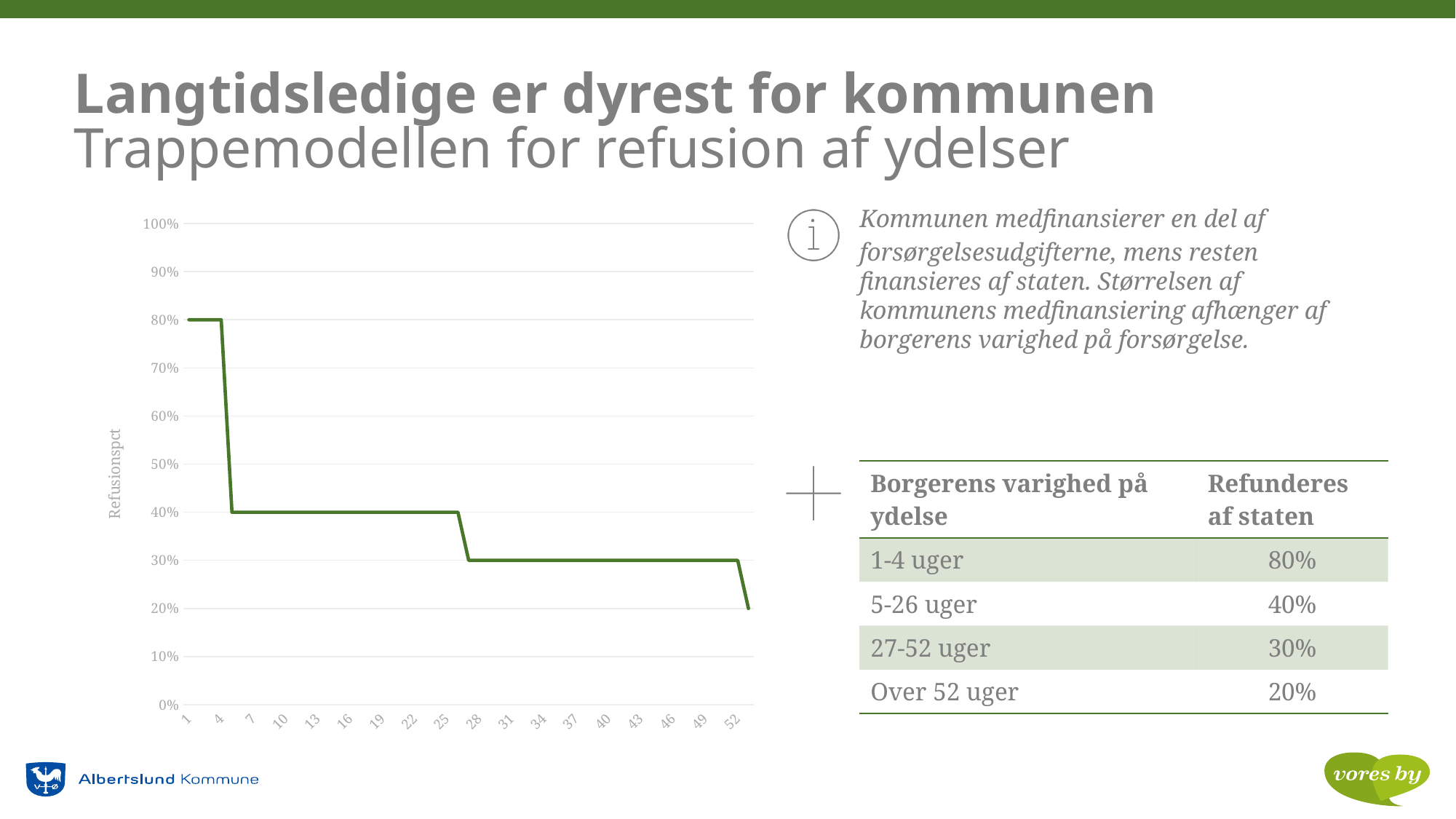
What kind of chart is shown on the slide? line chart What is the label on the vertical axis of the chart? Refusionspct What is the lowest refusion percentage shown on the chart? 20% What is the highest refusion percentage shown on the chart? 80% What is the refusion percentage at week 40 on the chart? 30% What is the refusion percentage at week 1 on the chart? 80% Which is larger, the refusion percentage at week 1 or at week 31? week 1 By how many percentage points does the refusion percentage drop between week 4 and week 7? 40 percentage points What is the refusion percentage at the right end of the line, after week 52? 20% Is the refusion percentage at week 20 greater or less than 50%? less What is the refusion percentage at week 10 on the chart? 40% Does the refusion percentage rise or fall as the number of weeks increases along the x axis? fall